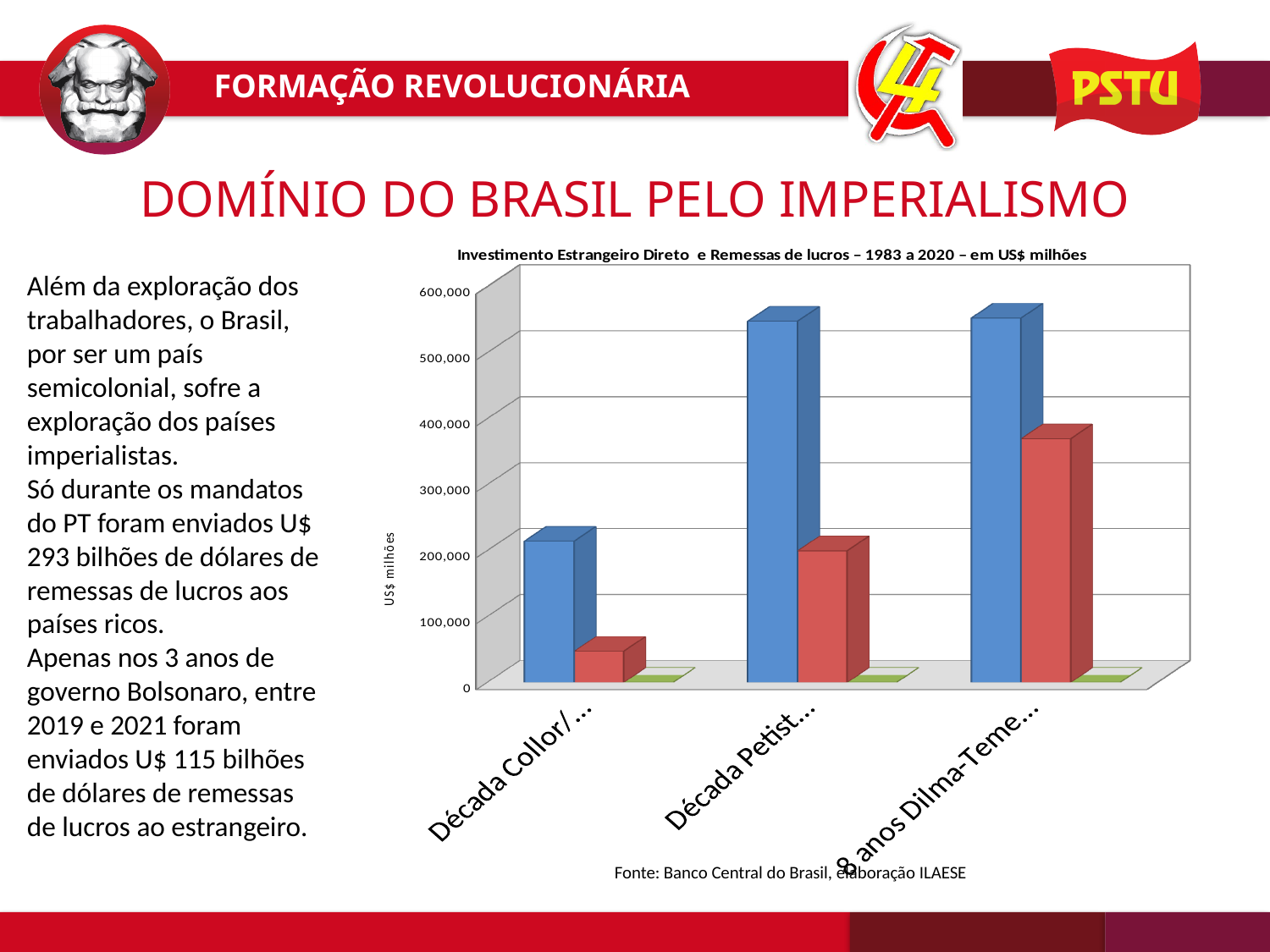
Is the value of the red bar for the second category (Década Petist...) greater or less than 300,000? less Is the value of the blue bar for the second category (Década Petist...) greater or less than 500,000? greater Which category has the lowest blue bar? Década Collor/... What is the label on the vertical axis of the chart? US$ milhões What kind of chart is shown on the slide? bar chart Which category has the lowest red bar? Década Collor/... How many categories are shown on the x axis of the chart? 3 Is the value of the red bar for the third category (8 anos Dilma-Teme...) greater or less than 300,000? greater Which category has the highest red bar? 8 anos Dilma-Teme... In the third category (8 anos Dilma-Teme...), which bar is larger, the blue one or the red one? the blue one